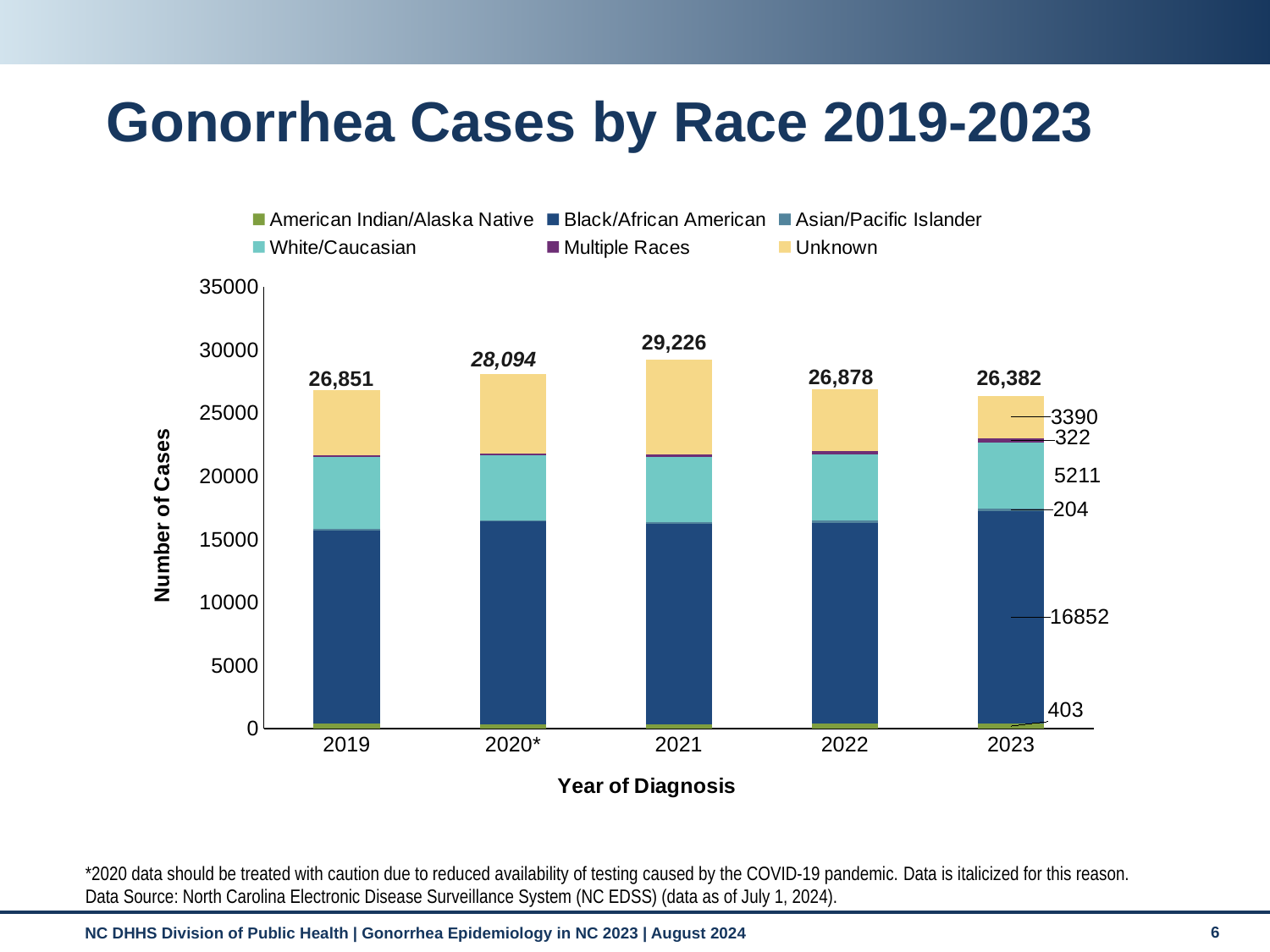
What is the difference between the total cases in 2021 and 2023? 2,844 What is the total number of gonorrhea cases labeled for 2019? 26,851 How many cases in 2023 are labeled as Unknown race? 3390 What is the total number of gonorrhea cases labeled for 2021? 29,226 Which year has the highest total number of cases? 2021 Which year has more total cases, 2020* or 2022? 2020* How many cases in 2023 are labeled for the Black/African American group? 16852 Which year has the lowest total number of cases? 2023 How many cases in 2023 are labeled for the White/Caucasian group? 5211 What kind of chart is shown on the slide? Stacked bar chart How many series does the legend list? 6 How many years are shown on the x axis? 5